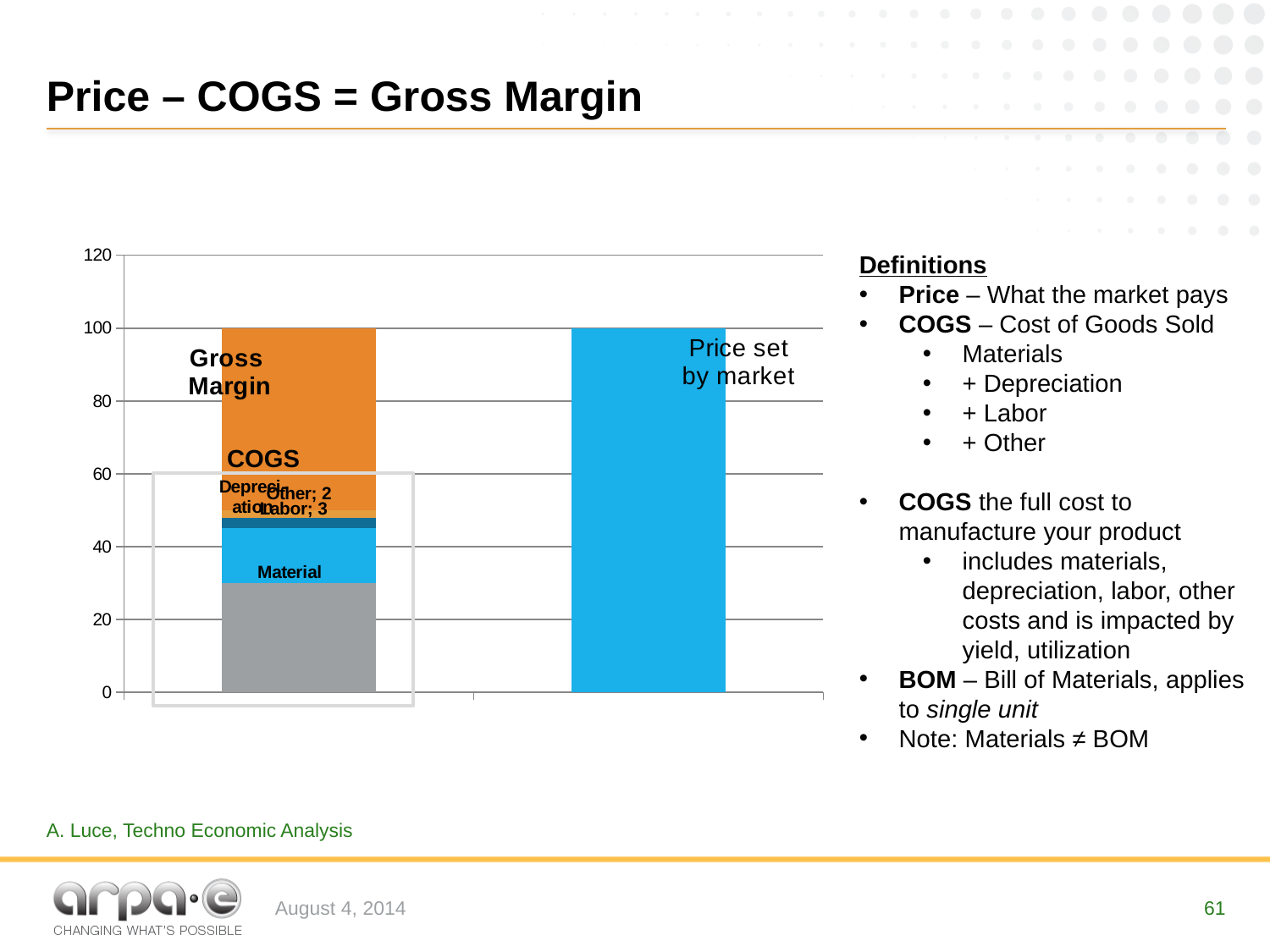
Is the top of the Material segment greater or less than 40? less What is the value of the Labor segment in the stacked bar? 3 What colour is the Material segment? gray What is the difference between the Labor value and the Other value? 1 What value does the 'Price set by market' bar reach on the axis? 100 Which is larger, the Labor segment or the Other segment? Labor What is the value of the Other segment in the stacked bar? 2 What colour is the Gross Margin segment? orange Is the top of the Material segment greater or less than 20? greater How many bars are plotted in the chart? 2 Which segment of the stacked bar is the largest? Gross Margin What kind of chart is shown on the slide? bar chart